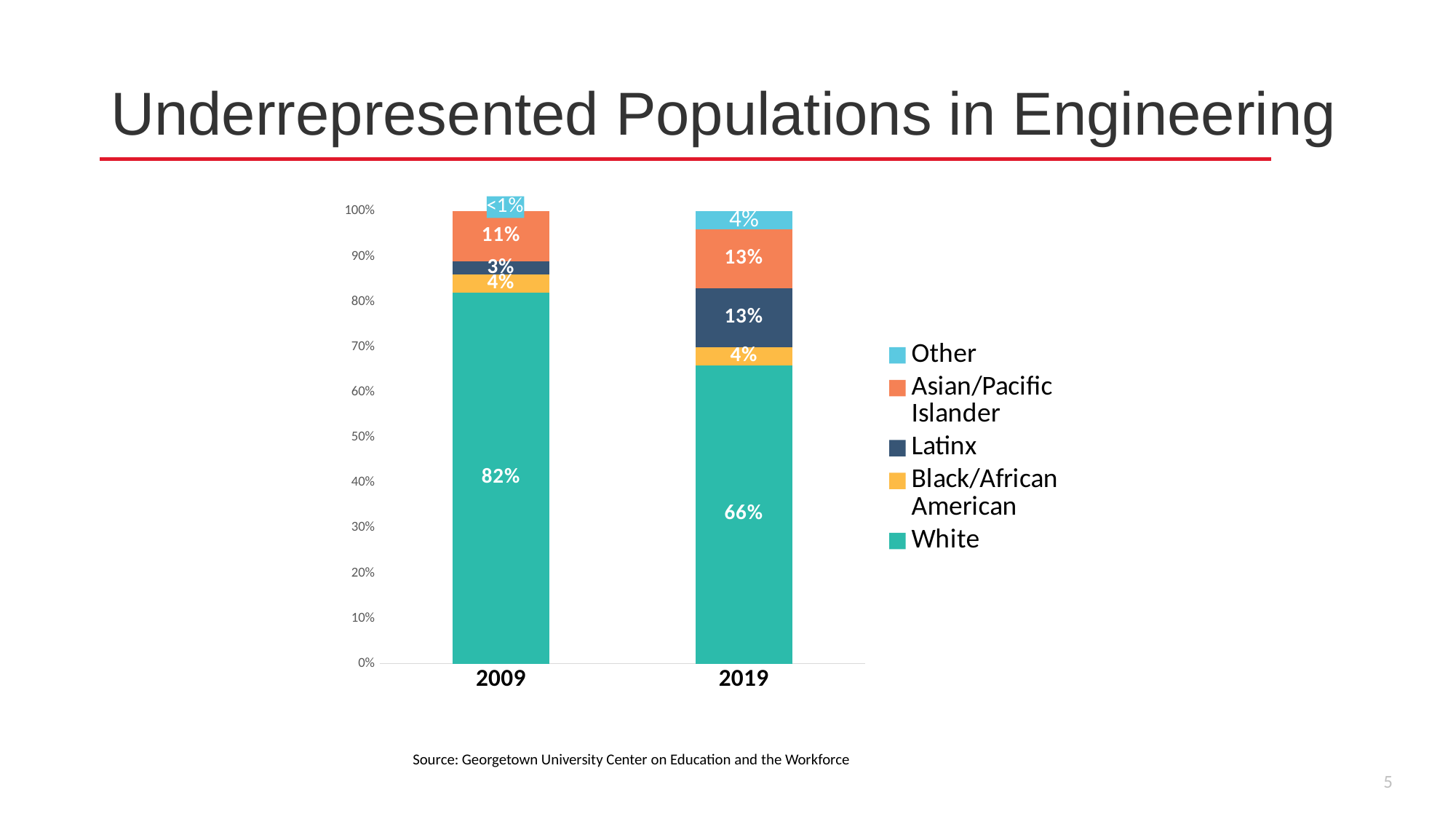
How many series does the legend list? 5 What percentage of the 2019 bar is White? 66% By how many percentage points did the Latinx share increase from 2009 to 2019? 10 percentage points What is the Other share in 2009? <1% Which year has the larger Asian/Pacific Islander share, 2009 or 2019? 2019 What is the Black/African American share in 2019? 4% What is the Asian/Pacific Islander share in 2009? 11% What kind of chart is shown on the slide? Stacked bar chart What percentage of the 2009 bar is White? 82% What is the Latinx share in 2019? 13% How many years are shown on the x axis? 2 By how many percentage points did the White share fall from 2009 to 2019? 16 percentage points